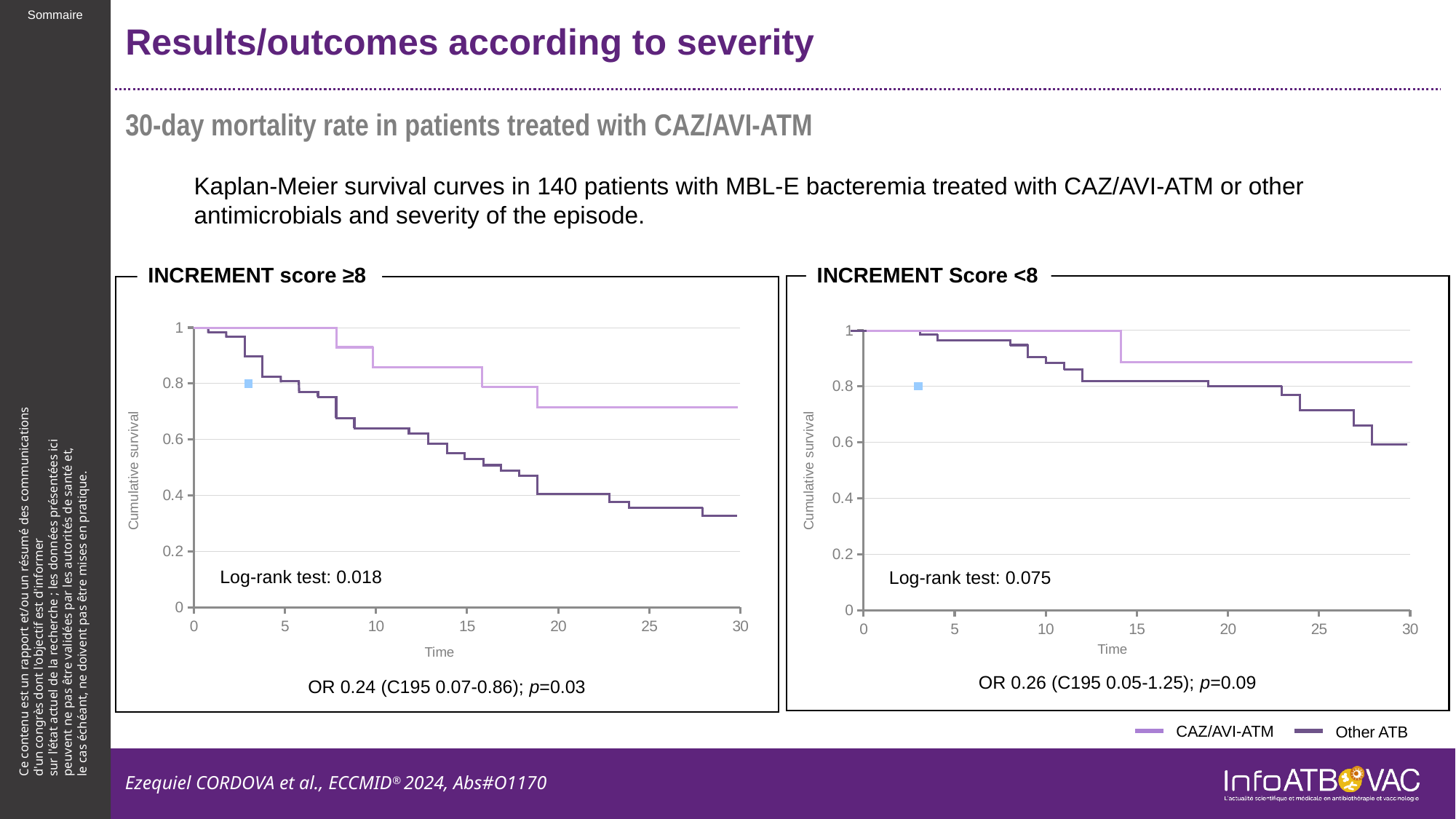
In the INCREMENT score ≥8 chart, is the cumulative survival for CAZ/AVI-ATM at time 30 greater or less than 0.6? greater What kind of chart is shown in the INCREMENT score ≥8 panel? line chart In the INCREMENT score ≥8 chart, does the Other ATB curve rise or fall as time increases? fall In the INCREMENT Score <8 chart, which series has the higher cumulative survival at time 30, CAZ/AVI-ATM or Other ATB? CAZ/AVI-ATM In the INCREMENT Score <8 chart, is the cumulative survival for Other ATB at time 30 greater or less than 0.8? less What log-rank test value is shown in the INCREMENT score ≥8 chart? 0.018 How many series does the legend list for the survival curves? 2 What log-rank test value is shown in the INCREMENT Score <8 chart? 0.075 In the INCREMENT score ≥8 chart, which series has the higher cumulative survival at time 30, CAZ/AVI-ATM or Other ATB? CAZ/AVI-ATM In the INCREMENT Score <8 chart, is the cumulative survival for CAZ/AVI-ATM at time 30 greater or less than 0.8? greater